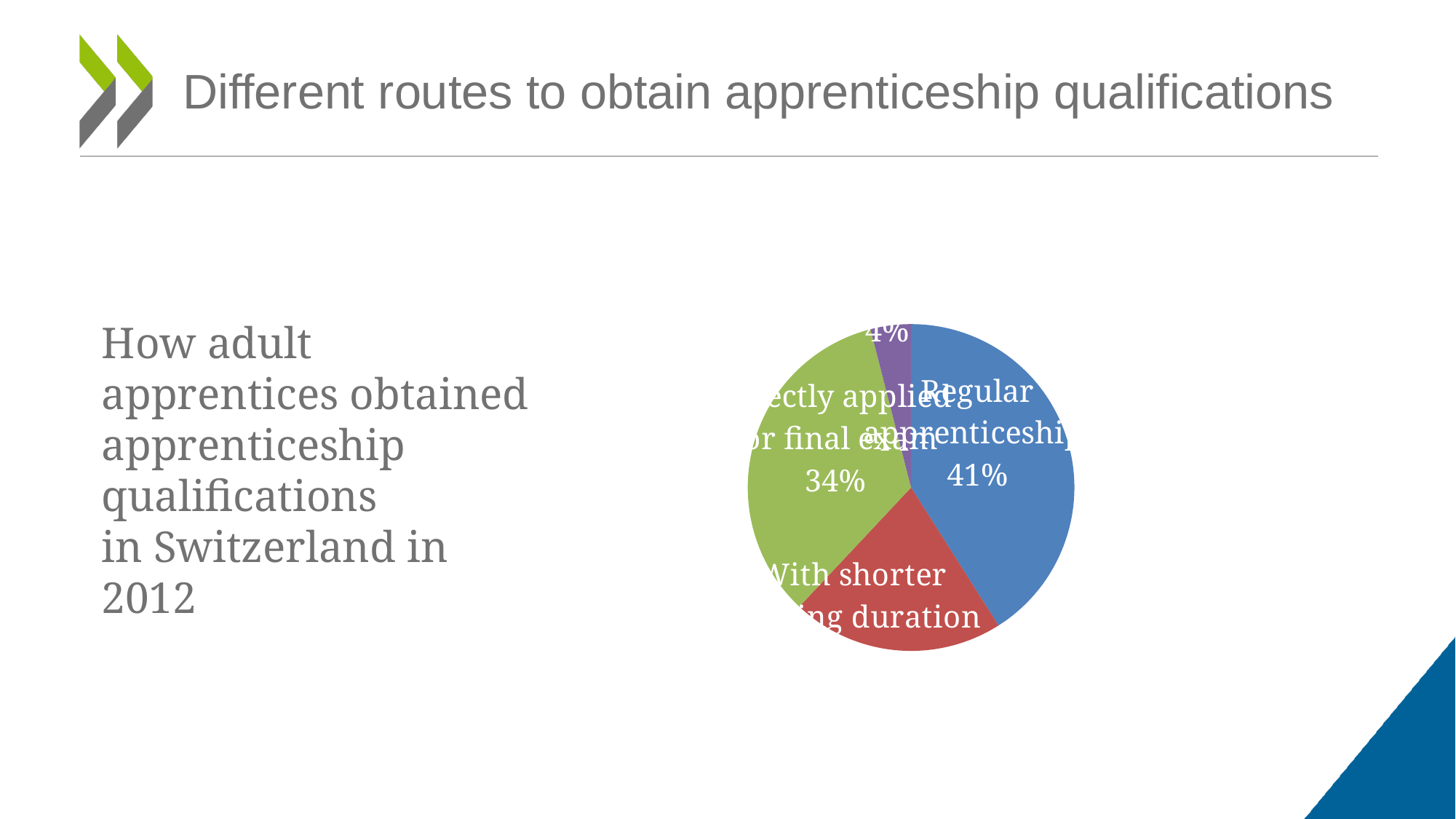
Which route has the largest share in the pie chart? Regular apprenticeship What colour is the Regular apprenticeship slice? Blue Which is larger, the Regular apprenticeship slice or the red slice? Regular apprenticeship What share of adult apprentices obtained their qualification through a Regular apprenticeship? 41% What kind of chart is shown on the slide? Pie chart How many slices does the pie chart have? 4 Which is larger, the Regular apprenticeship slice or the green slice labelled 34%? Regular apprenticeship What is the difference in percentage points between the Regular apprenticeship slice (41%) and the 34% slice? 7 percentage points Which country and year does the pie chart describe? Switzerland, 2012 What is the smallest percentage shown on the pie chart? 4%